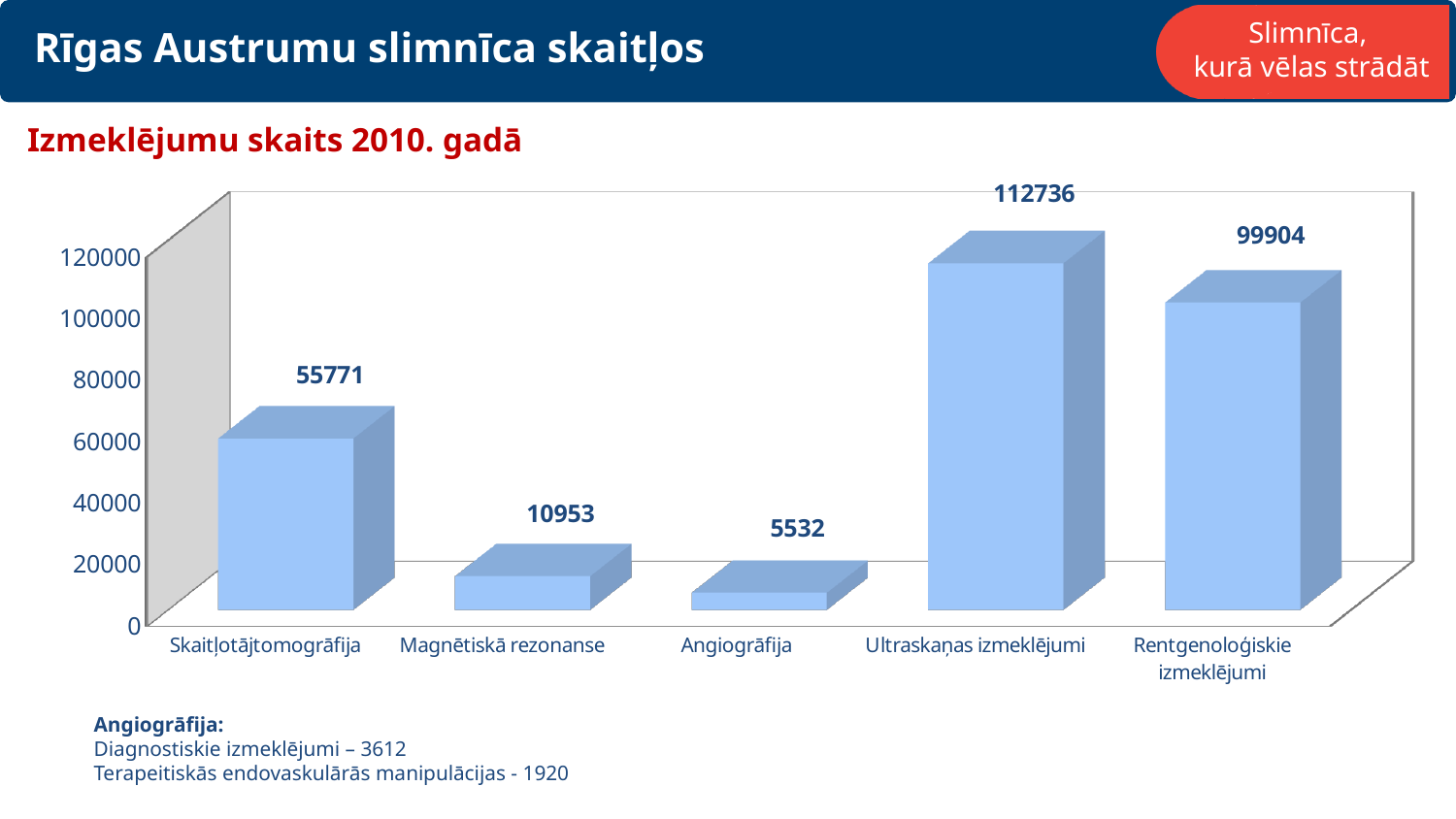
How many categories are shown in the chart? 5 What is the difference between Ultraskaņas izmeklējumi and Rentgenoloģiskie izmeklējumi? 12832 Which category has the highest value? Ultraskaņas izmeklējumi What is the value for Magnētiskā rezonanse? 10953 What is the title of the chart? Izmeklējumu skaits 2010. gadā What is the value for Ultraskaņas izmeklējumi? 112736 Which is larger, Skaitļotājtomogrāfija or Magnētiskā rezonanse? Skaitļotājtomogrāfija What is the value for Skaitļotājtomogrāfija? 55771 What kind of chart is shown on the slide? bar chart Is the value for Rentgenoloģiskie izmeklējumi greater or less than 80000? greater Which category has the lowest value? Angiogrāfija What is the value for Angiogrāfija? 5532